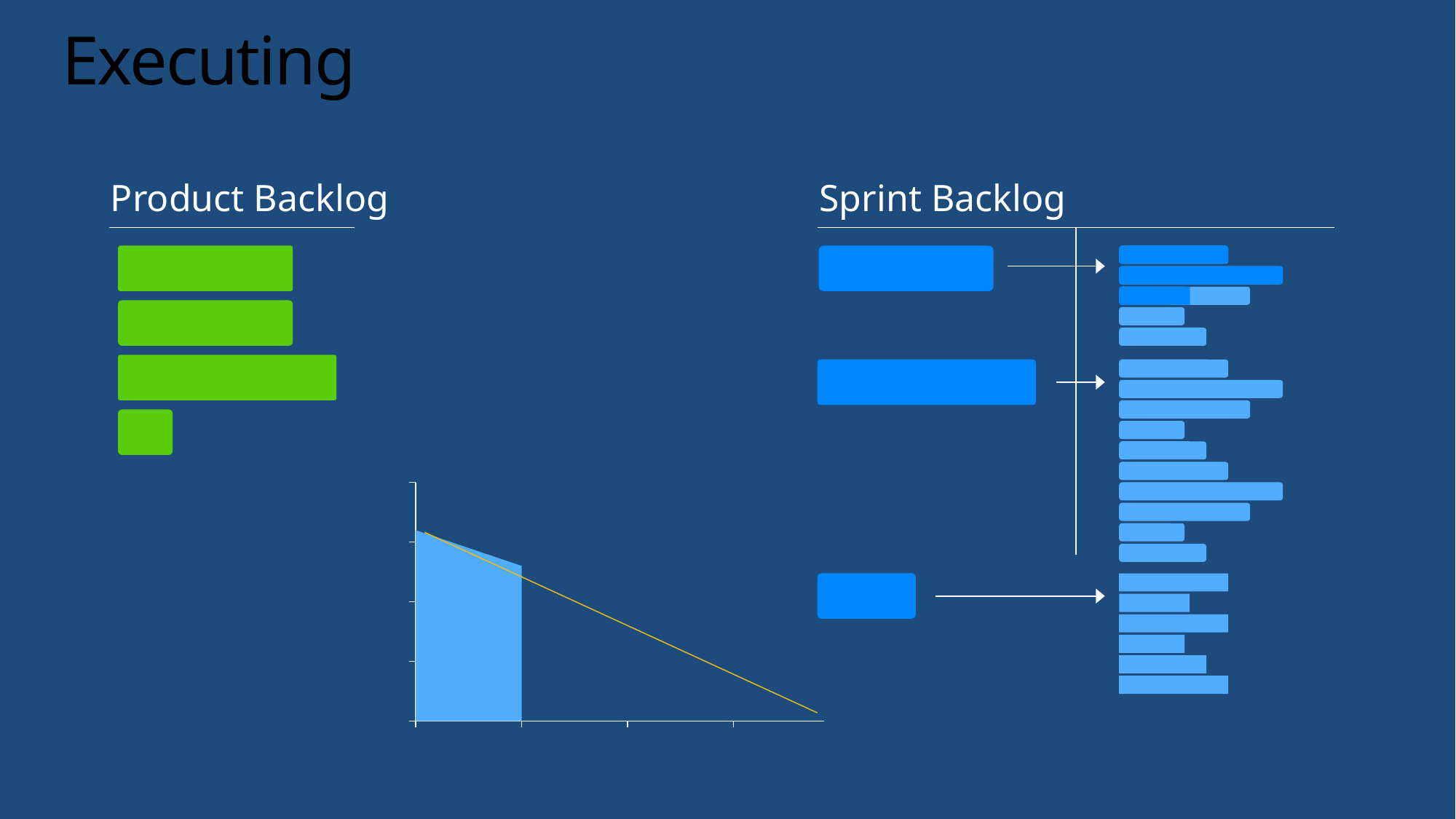
Does the chart at the bottom centre of the slide have a title? No What kind of chart is shown at the bottom centre of the slide? area chart with a line In the chart at the bottom centre of the slide, do the values rise or fall along the x axis? fall What colour is the shaded area in the chart at the bottom centre of the slide? light blue In the chart at the bottom centre of the slide, does the straight line rise or fall from left to right? fall